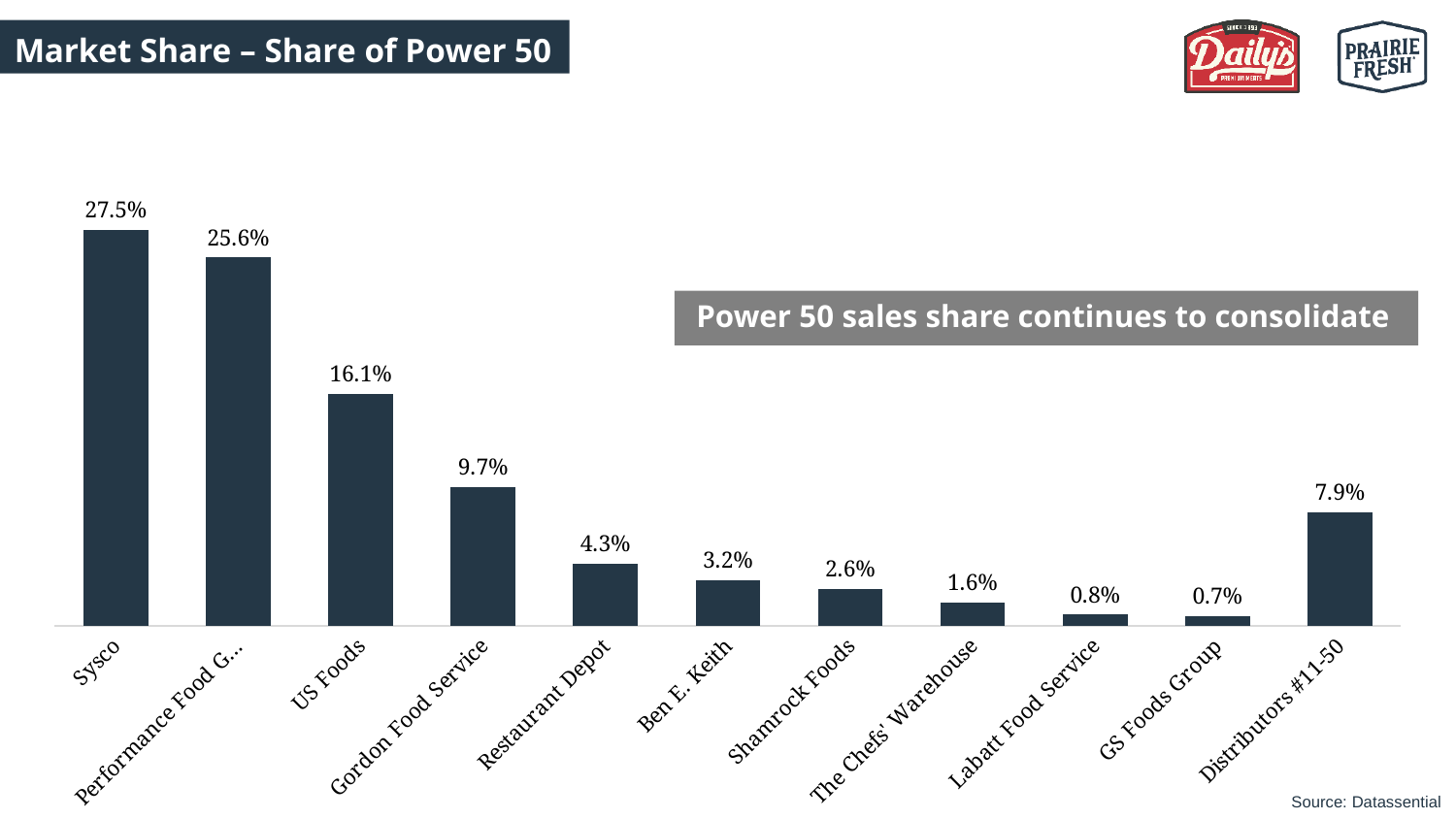
What is the value for The Chefs' Warehouse? 1.6% What is the title of the slide? Market Share – Share of Power 50 What is the value for US Foods? 16.1% What is the difference between the values for Sysco and US Foods? 11.4% Which category has the lowest value? GS Foods Group What is the value for Distributors #11-50? 7.9% What is the value for Gordon Food Service? 9.7% What is the value for Sysco? 27.5% What kind of chart is shown on the slide? Bar chart Which category has the highest value? Sysco How many categories are shown on the chart? 11 Which is larger, the value for Restaurant Depot or the value for Distributors #11-50? Distributors #11-50